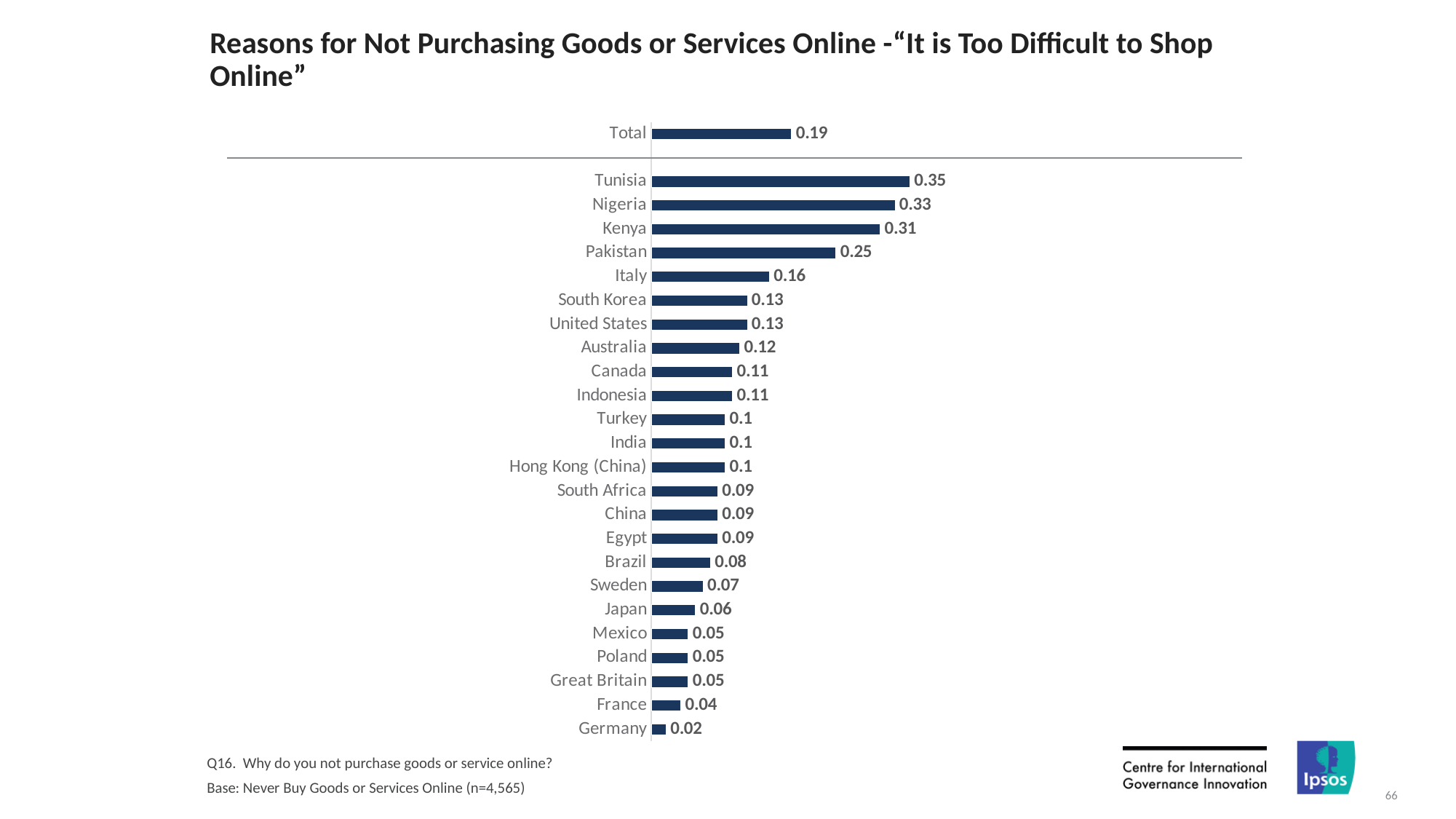
What is the value for Japan? 0.06 What type of chart is shown on the slide? Bar chart What is the value for Total? 0.19 What is the value for Tunisia? 0.35 How many countries are listed below the Total bar? 24 What is the difference between the values for Kenya and Germany? 0.29 What is the value for Italy? 0.16 Which has a larger value, Australia or Brazil? Australia What is the difference between the values for Nigeria and Pakistan? 0.08 Which country has the highest value? Tunisia What is the title of the chart? Reasons for Not Purchasing Goods or Services Online - "It is Too Difficult to Shop Online" Which country has the lowest value? Germany